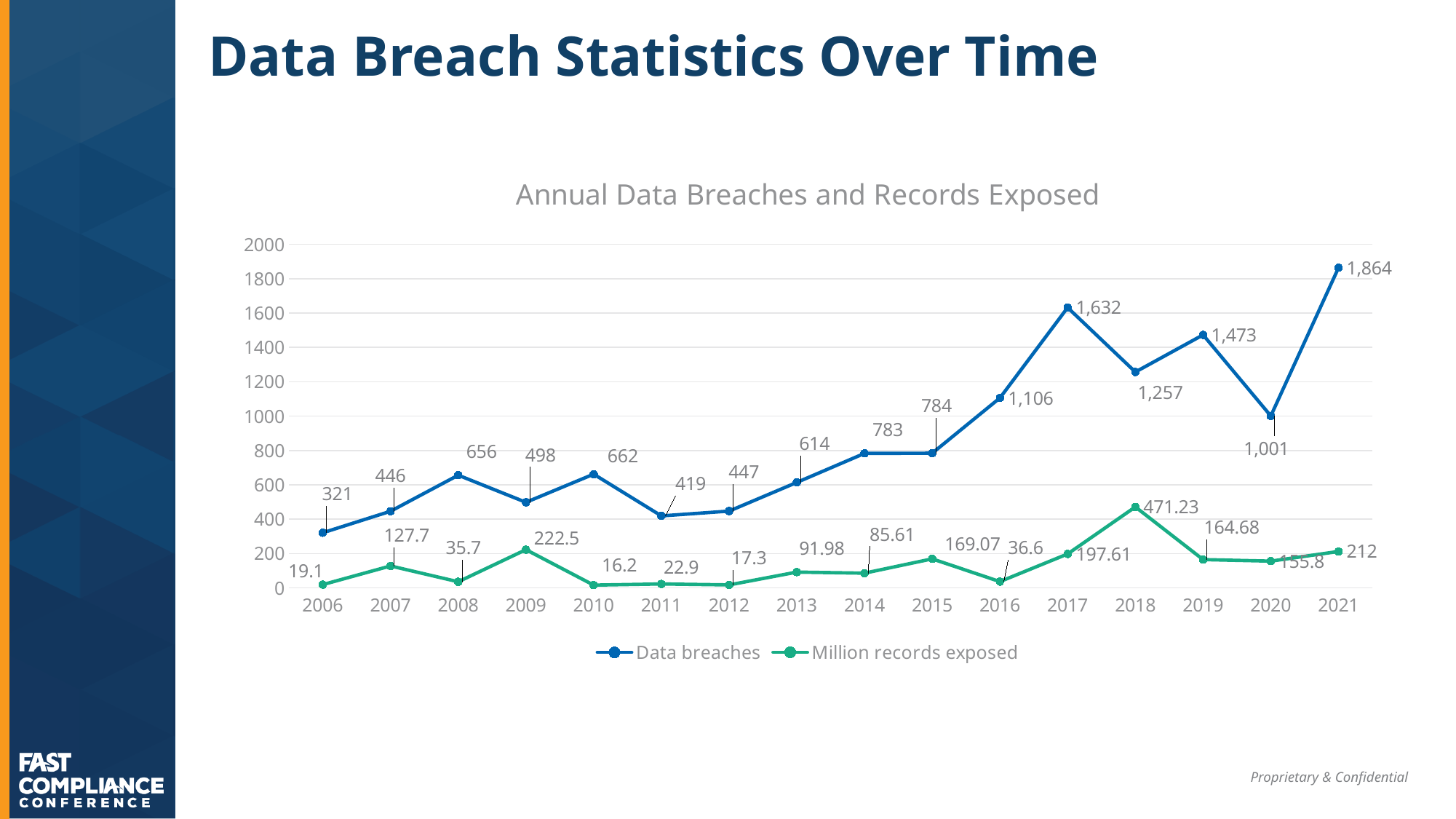
What is the value for Data breaches in 2006? 321 In which year is the Data breaches series lowest? 2006 What kind of chart is shown on the slide? Line chart Which year has more Data breaches, 2019 or 2020? 2019 What is the difference in Data breaches between 2017 and 2018? 375 How many years are plotted on the x axis? 16 In which year is the Data breaches series highest? 2021 Is the value for Data breaches in 2016 greater or less than 1000? greater What is the value for Million records exposed in 2018? 471.23 What is the value for Data breaches in 2021? 1,864 How many series does the legend list? 2 In which year is the Million records exposed series highest? 2018